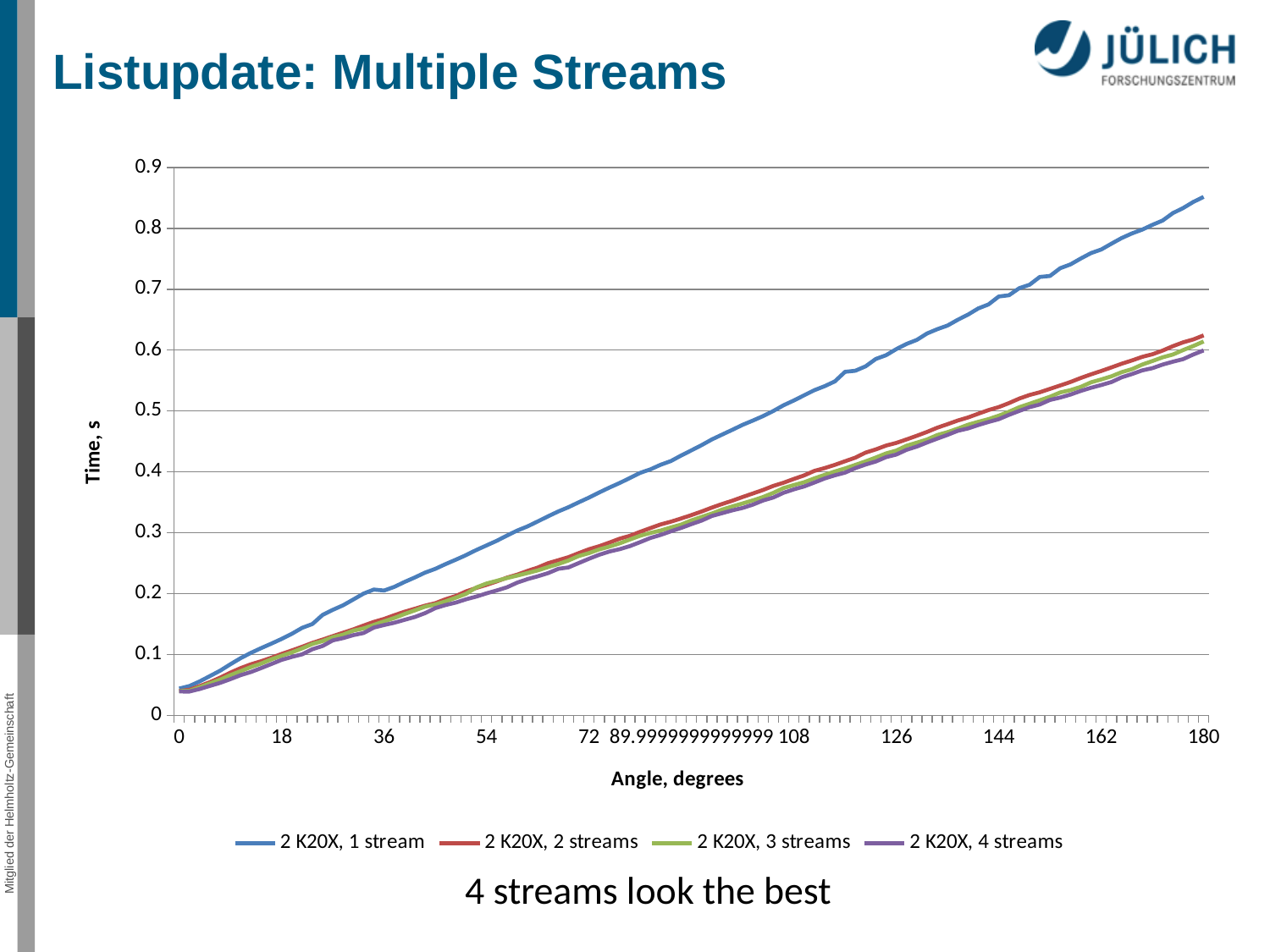
Is the value for '2 K20X, 4 streams' at 180 degrees greater or less than 0.7? less How many series does the legend list? 4 Which series has the highest time at 180 degrees? 2 K20X, 1 stream Is the value for '2 K20X, 1 stream' at 180 degrees greater or less than 0.8? greater What kind of chart is shown on the slide? line chart At 180 degrees, which is larger: the time for '2 K20X, 1 stream' or for '2 K20X, 4 streams'? 2 K20X, 1 stream Is the value for '2 K20X, 1 stream' at 90 degrees greater or less than 0.3? greater What is the label of the x axis? Angle, degrees Does the time for '2 K20X, 1 stream' rise or fall as the angle increases? rise What is the label of the y axis? Time, s